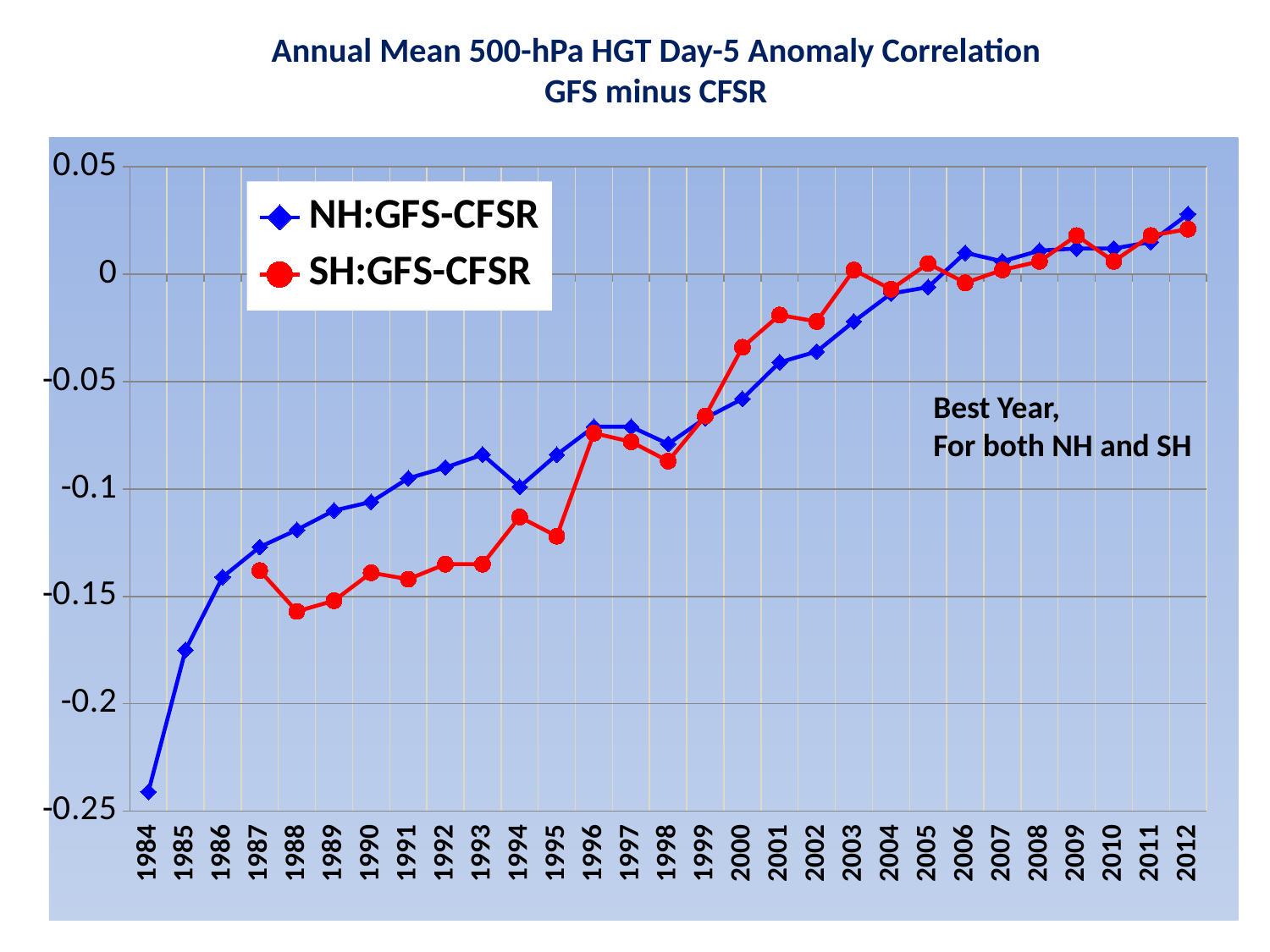
Do the NH:GFS-CFSR values generally rise or fall from 1984 to 2012? rise Which series is drawn in red? SH:GFS-CFSR What is the first year for which the SH:GFS-CFSR series has a data point? 1987 What kind of chart is shown on the slide? line chart Is the NH:GFS-CFSR value for 1984 greater or less than -0.2? less Is the NH:GFS-CFSR value for 1996 greater or less than -0.1? greater In which year is the NH:GFS-CFSR value lowest? 1984 How many years are shown along the x axis? 29 In which year is the NH:GFS-CFSR value highest? 2012 In 1990, which series has the higher value, NH:GFS-CFSR or SH:GFS-CFSR? NH:GFS-CFSR Is the SH:GFS-CFSR value for 1987 greater or less than -0.1? less How many series does the legend list? 2